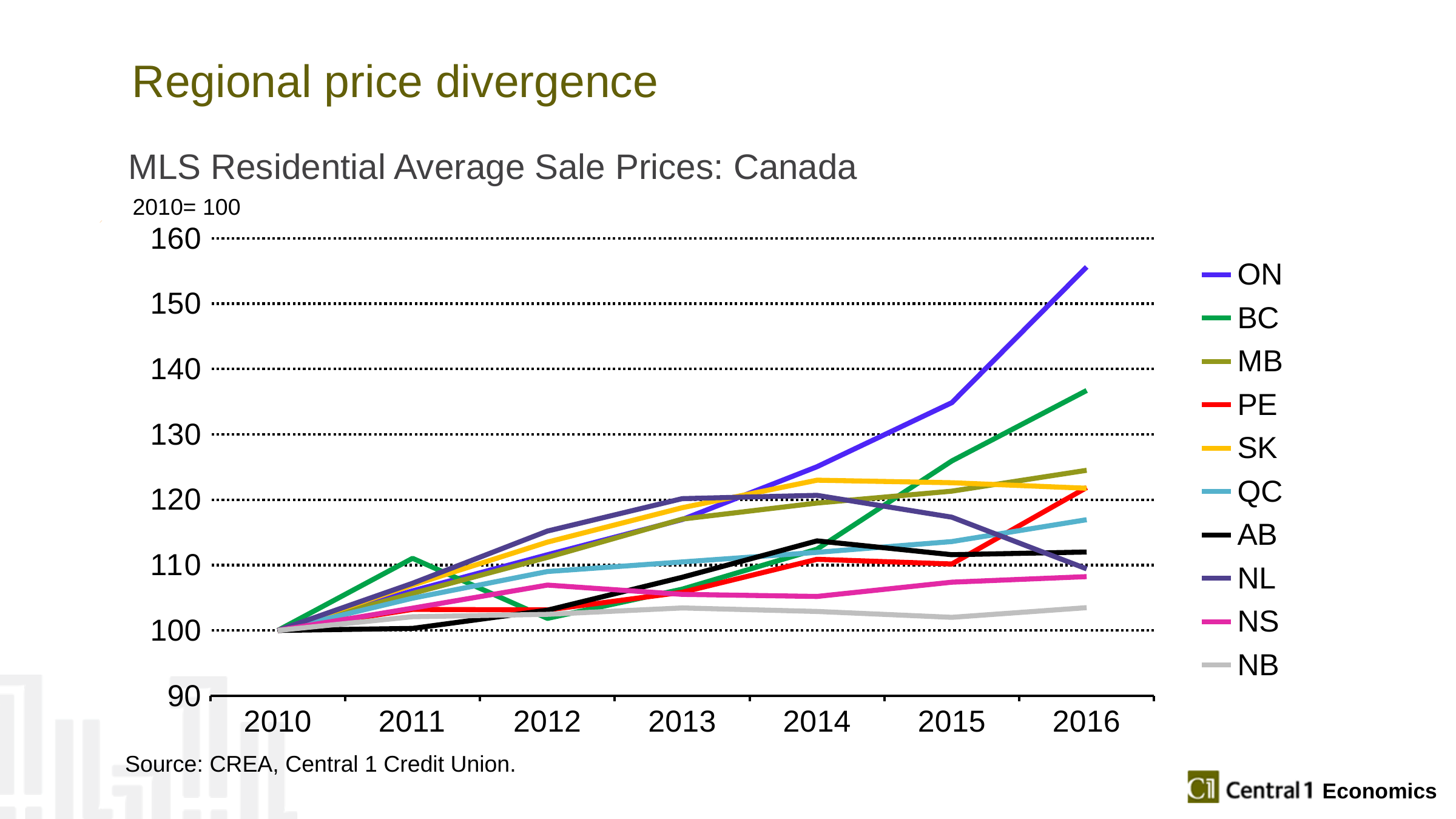
Is the value for ON in 2016 greater or less than 150? greater How many years are shown on the x axis? 7 Is the value for BC in 2016 greater or less than 130? greater How many series does the legend list? 10 Which province has the lowest index value in 2016? NB Is the value for NB in 2016 greater or less than 110? less What is the title of the chart? MLS Residential Average Sale Prices: Canada Which province has the highest index value in 2016? ON In 2016, which is larger, the value for SK or the value for NS? SK What type of chart is shown on the slide? line chart What is the index value for ON in 2010? 100 Does the ON line rise or fall from 2010 to 2016? rise